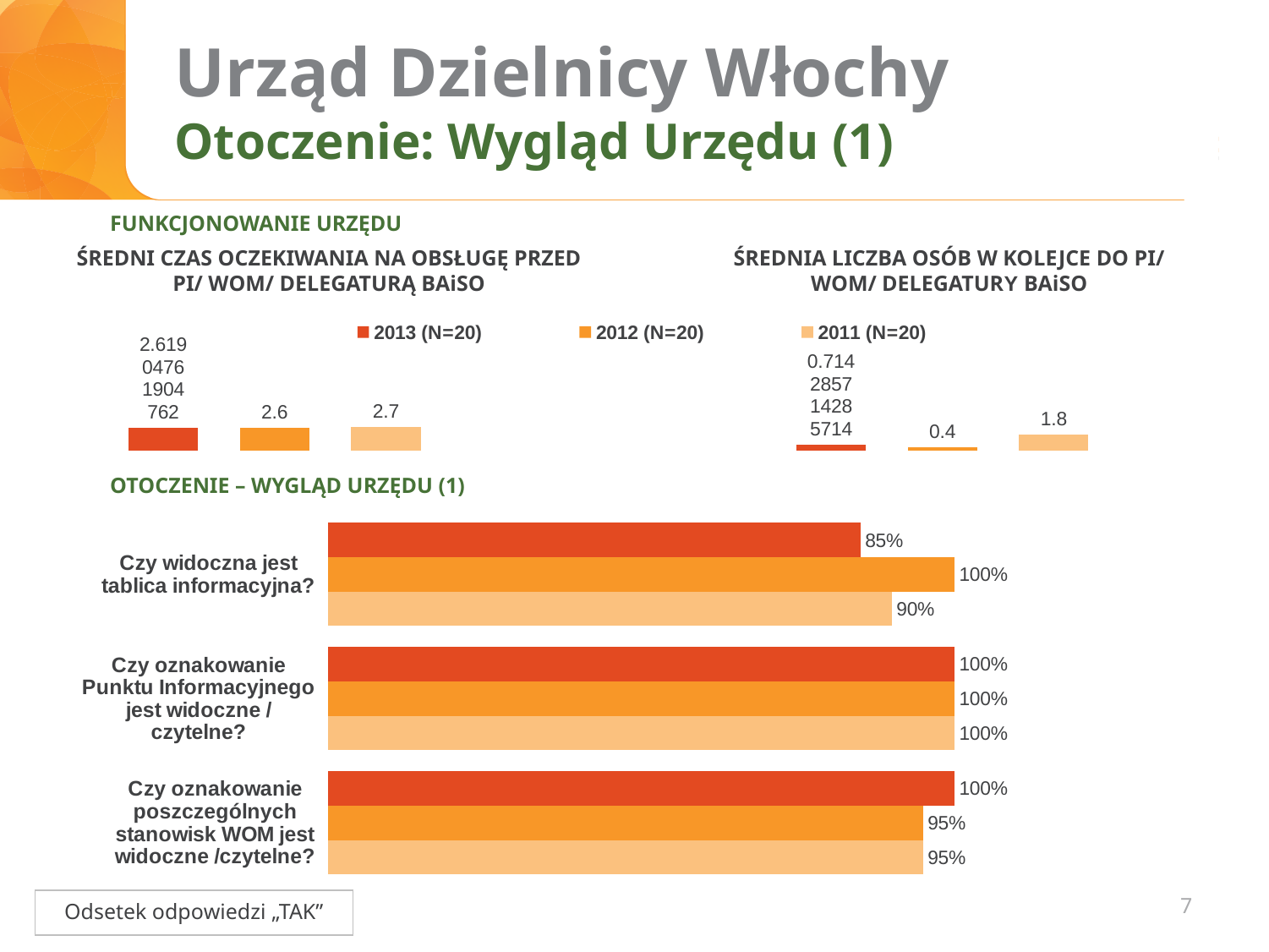
In the chart "ŚREDNIA LICZBA OSÓB W KOLEJCE DO PI/ WOM/ DELEGATURY BAiSO", what is the value for 2011? 1.8 In the bottom chart (Otoczenie – Wygląd Urzędu), how many question categories are shown? 3 In the bottom chart (Otoczenie – Wygląd Urzędu), what percentage is shown for 2011 for "Czy oznakowanie poszczególnych stanowisk WOM jest widoczne /czytelne?"? 95% In the chart "ŚREDNI CZAS OCZEKIWANIA NA OBSŁUGĘ PRZED PI/ WOM/ DELEGATURĄ BAiSO", which is larger, the value for 2012 or for 2011? 2011 In the bottom chart (Otoczenie – Wygląd Urzędu), which year has the lowest value for "Czy widoczna jest tablica informacyjna?"? 2013 In the bottom chart (Otoczenie – Wygląd Urzędu), what is the difference between the 2012 and 2013 values for "Czy widoczna jest tablica informacyjna?"? 15 percentage points In the bottom chart (Otoczenie – Wygląd Urzędu), what percentage is shown for 2012 for "Czy widoczna jest tablica informacyjna?"? 100% How many series does the legend above the top charts list? 3 In the chart "ŚREDNI CZAS OCZEKIWANIA NA OBSŁUGĘ PRZED PI/ WOM/ DELEGATURĄ BAiSO", what is the value for 2011? 2.7 What type of chart is the bottom chart (Otoczenie – Wygląd Urzędu)? Bar chart In the chart "ŚREDNIA LICZBA OSÓB W KOLEJCE DO PI/ WOM/ DELEGATURY BAiSO", which year has the lowest value? 2012 In the bottom chart (Otoczenie – Wygląd Urzędu), what percentage is shown for 2013 for "Czy widoczna jest tablica informacyjna?"? 85%